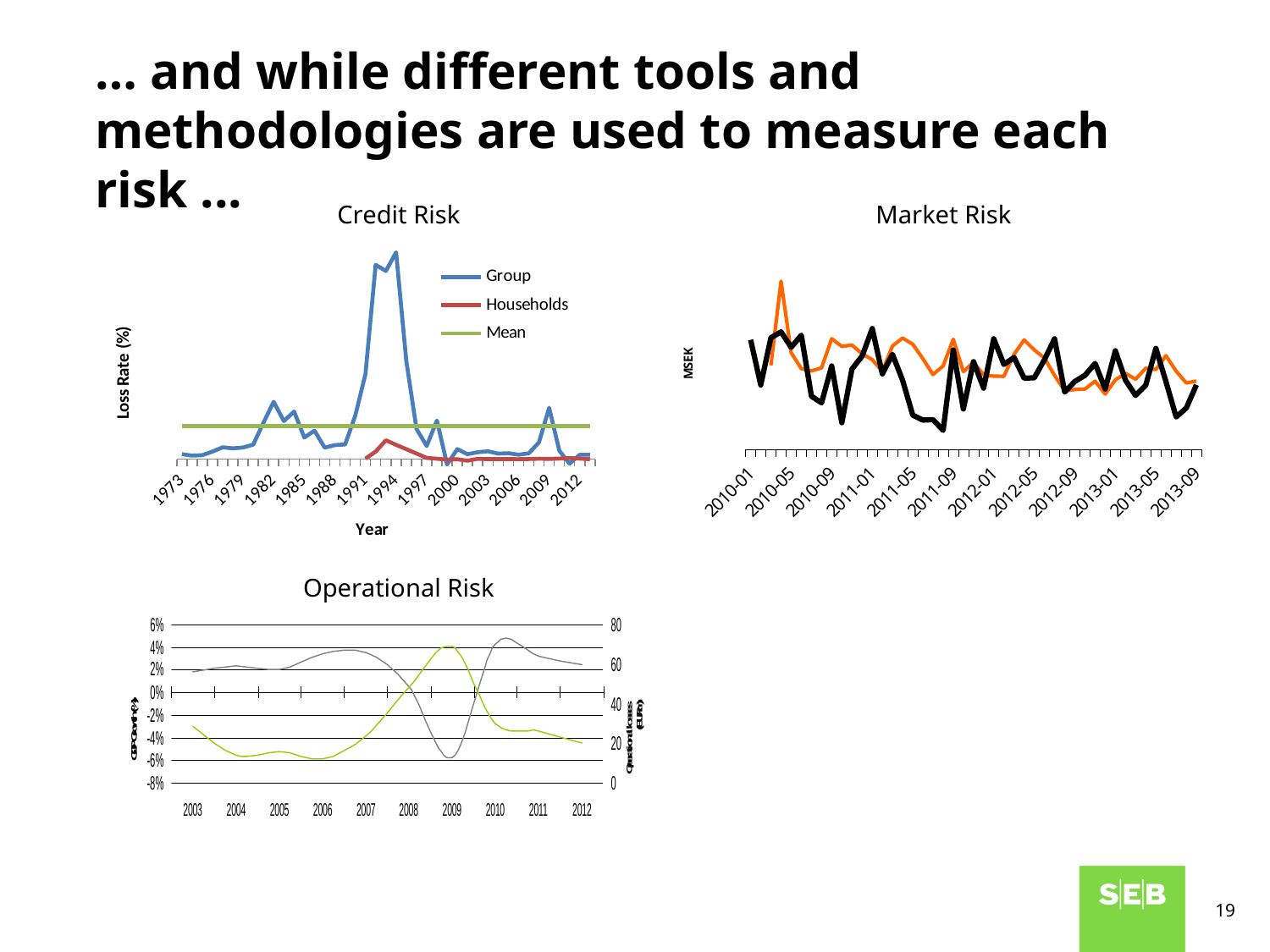
How many series does the legend of the Credit Risk chart list? 3 How many charts are shown on the slide? 3 What is the first year shown on the x axis of the Credit Risk chart? 1973 In the Credit Risk chart, which series reaches the highest peak? Group In the Operational Risk chart, is the value of the grey line in 2010 greater or less than 2% on the left axis? greater What is the y-axis label of the Credit Risk chart? Loss Rate (%) What is the last period shown on the x axis of the Market Risk chart? 2013-09 What type of chart is the Credit Risk chart? Line chart In the Operational Risk chart, is the value of the grey line in 2009 greater or less than -4% on the left axis? less How many years are shown on the x axis of the Operational Risk chart? 10 What is the y-axis label of the Market Risk chart? MSEK What type of chart is the Market Risk chart? Line chart